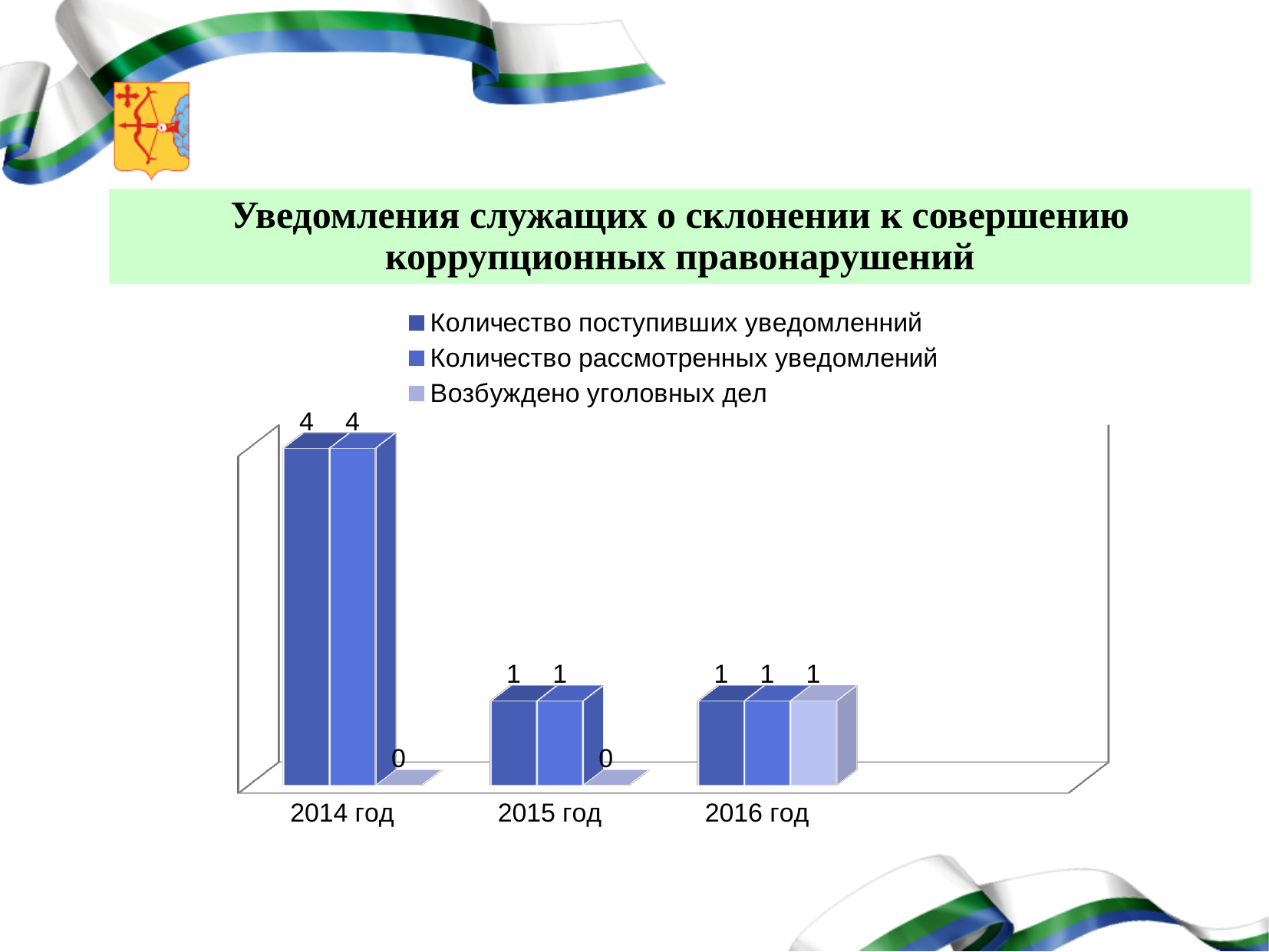
What is the value of "Возбуждено уголовных дел" for 2016 год? 1 In which year is "Возбуждено уголовных дел" highest? 2016 год In which year is "Количество поступивших уведомленний" highest? 2014 год What is the value of "Количество рассмотренных уведомлений" for 2015 год? 1 What is the value of "Возбуждено уголовных дел" for 2015 год? 0 What is the difference between "Количество поступивших уведомленний" in 2014 год and in 2015 год? 3 Does "Количество поступивших уведомленний" rise or fall from 2014 год to 2015 год? Fall How many series does the legend list? 3 Which is larger: "Количество рассмотренных уведомлений" in 2014 год or in 2016 год? 2014 год What kind of chart is shown on the slide? Bar chart How many years are shown on the x axis? 3 What is the value of "Количество поступивших уведомленний" for 2014 год? 4